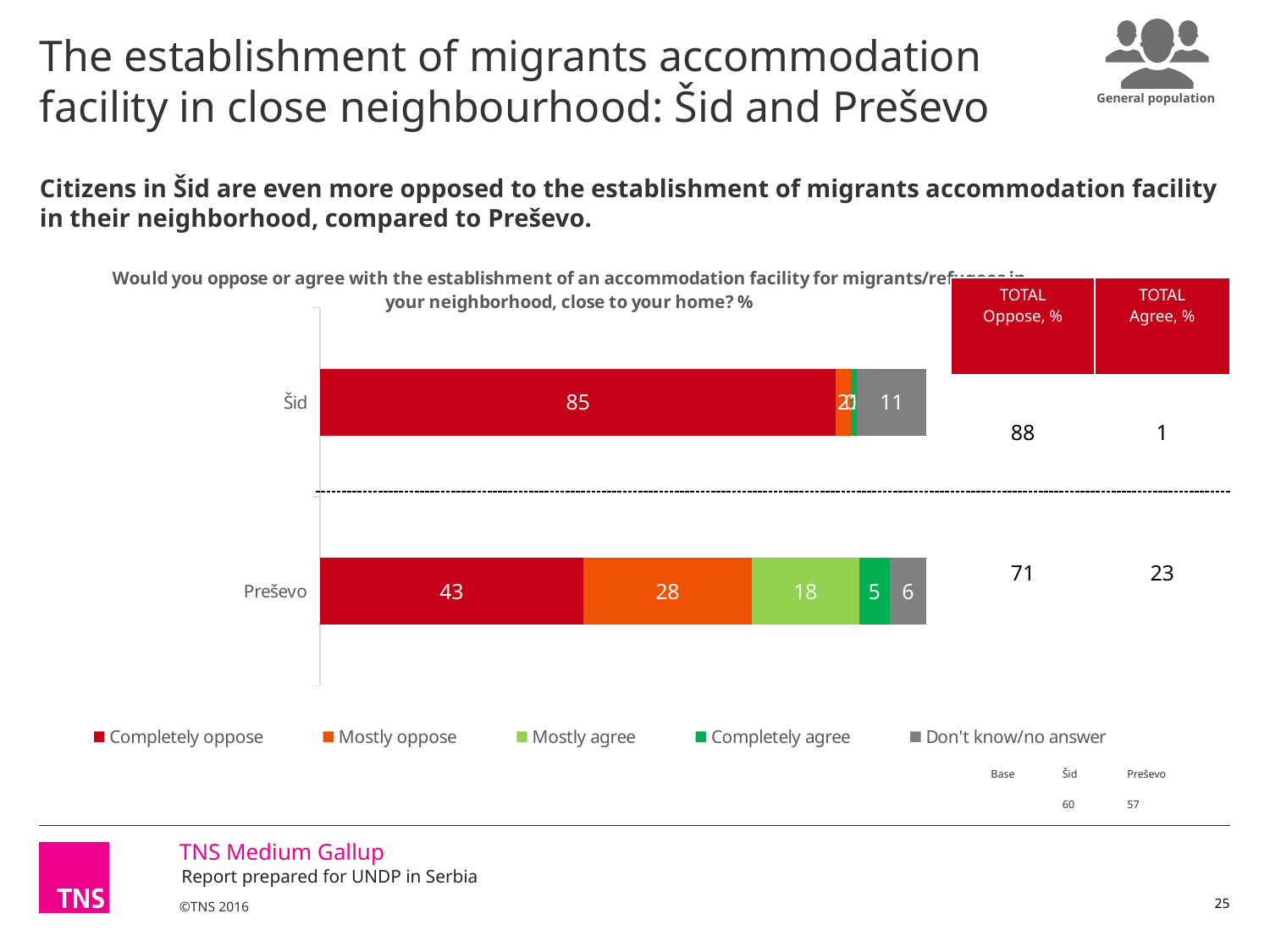
What is the value for 'Don't know/no answer' in Šid? 11 What is the difference between the 'Completely oppose' values for Šid and Preševo? 42 What kind of chart is shown on the slide? Stacked bar chart What is the value for 'Completely agree' in Preševo? 5 How many series does the legend list? 5 What percentage of respondents in Šid completely oppose the establishment of an accommodation facility? 85 What is the value for 'Mostly oppose' in Preševo? 28 How many locations (categories) are shown in the chart? 2 Which location has the larger 'Completely oppose' value, Šid or Preševo? Šid What is the value for 'Mostly agree' in Preševo? 18 What percentage of respondents in Preševo completely oppose the establishment of an accommodation facility? 43 In Preševo, what is the difference between the 'Mostly oppose' and 'Mostly agree' values? 10